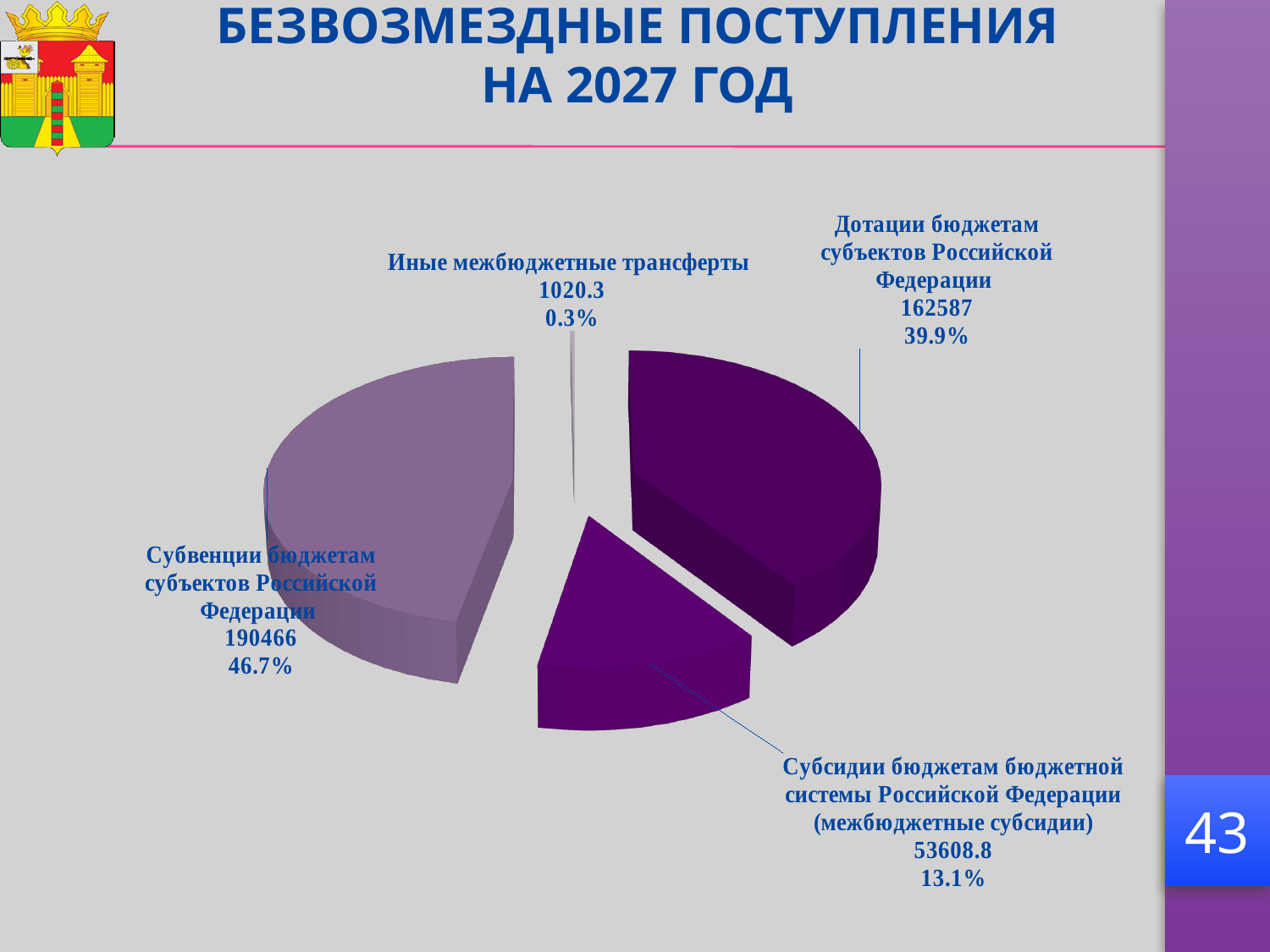
Which category has the largest slice of the pie? Субвенции бюджетам субъектов Российской Федерации What is the value for Субвенции бюджетам субъектов Российской Федерации? 190466 What share of the pie does Дотации бюджетам субъектов Российской Федерации represent? 39.9% What is the value for Субсидии бюджетам бюджетной системы Российской Федерации (межбюджетные субсидии)? 53608.8 What share of the pie does Иные межбюджетные трансферты represent? 0.3% What is the title of the slide containing the pie chart? БЕЗВОЗМЕЗДНЫЕ ПОСТУПЛЕНИЯ НА 2027 ГОД What is the value for Дотации бюджетам субъектов Российской Федерации? 162587 Which is larger: the value for Дотации бюджетам субъектов Российской Федерации or the value for Субсидии бюджетам бюджетной системы Российской Федерации (межбюджетные субсидии)? Дотации бюджетам субъектов Российской Федерации What kind of chart is shown on the slide? pie chart What is the value for Иные межбюджетные трансферты? 1020.3 Which category has the smallest slice of the pie? Иные межбюджетные трансферты How many slices does the pie chart have? 4